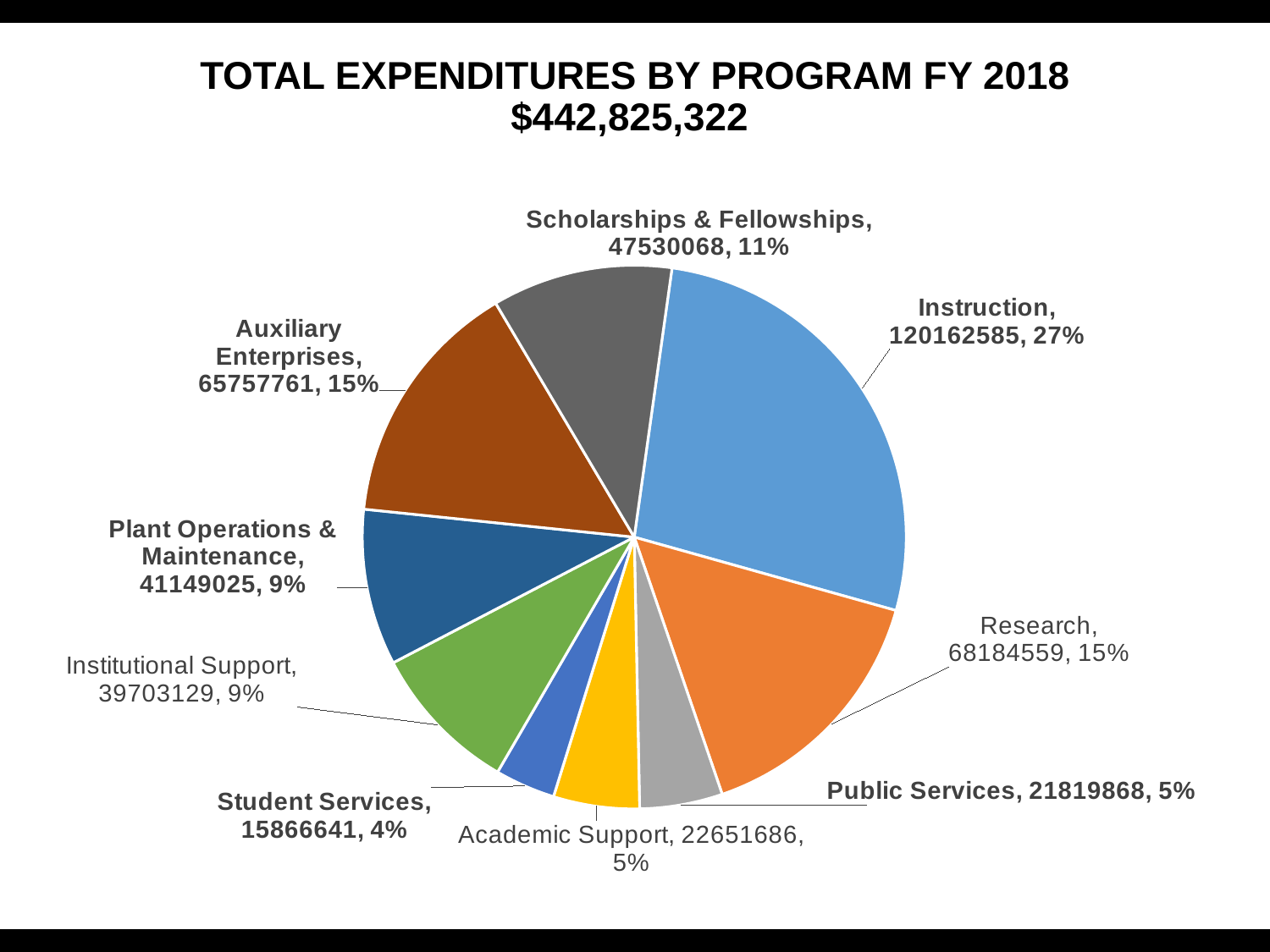
What percentage share does Student Services have? 4% What percentage share does Scholarships & Fellowships have? 11% What is the difference between the Instruction and Research values? 51978026 Which is larger, the value for Research or the value for Auxiliary Enterprises? Research What is the value for Instruction? 120162585 What is the value for Plant Operations & Maintenance? 41149025 What kind of chart is shown on the slide? Pie chart Which program has the lowest expenditure? Student Services What total amount is shown in the chart title? $442,825,322 What is the difference between the Auxiliary Enterprises and Scholarships & Fellowships values? 18227693 Which program has the highest expenditure? Instruction How many slices does the pie chart have? 9